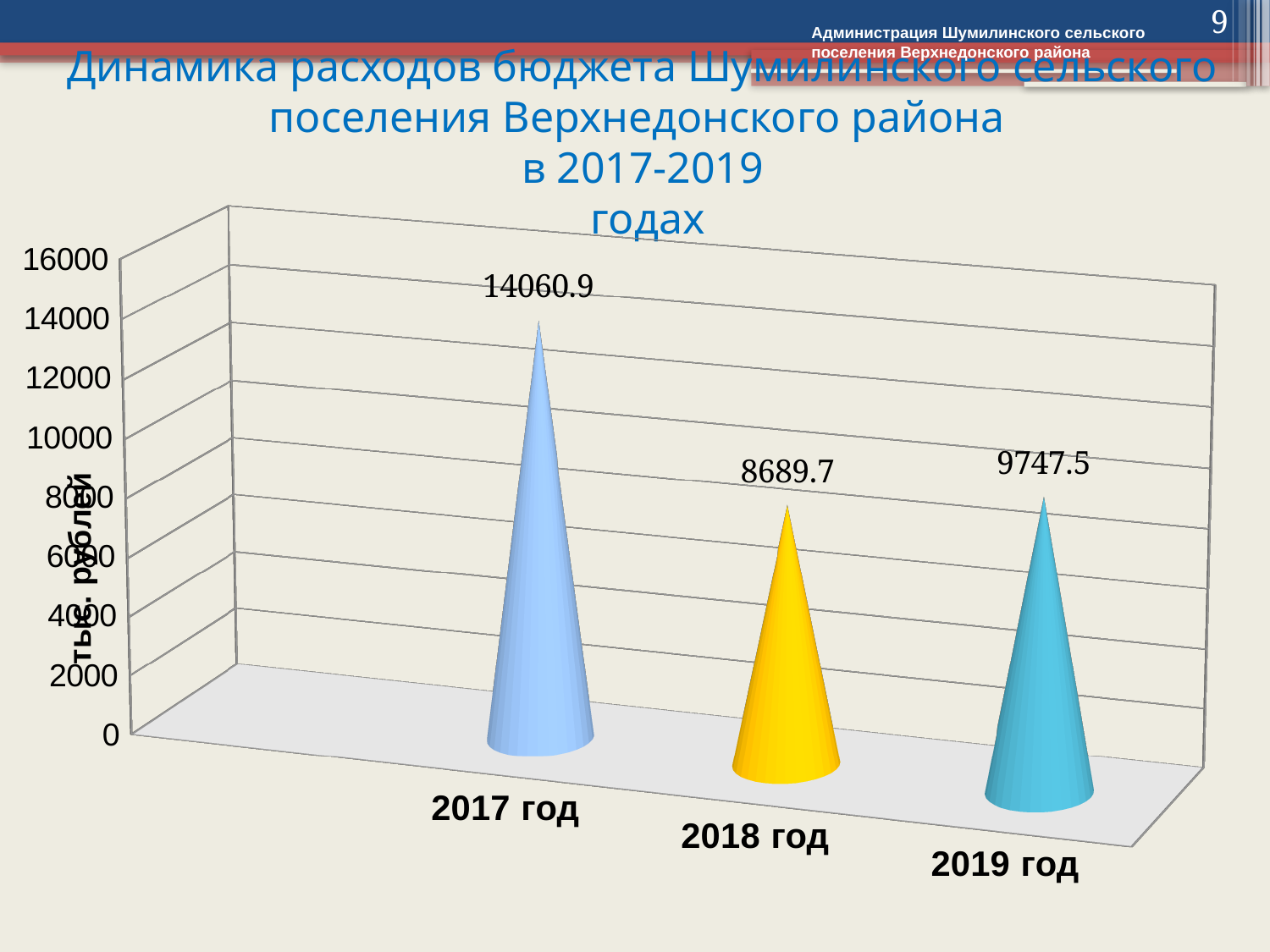
What is the difference between the values for 2017 год and 2018 год? 5371.2 Do the values rise or fall from 2017 год to 2018 год? fall What is the value shown for 2019 год? 9747.5 What is the difference between the values for 2019 год and 2018 год? 1057.8 Is the value for 2017 год greater or less than 12000? greater What unit is given on the vertical axis label of the chart? тыс. рублей What is the value shown for 2018 год? 8689.7 Which is larger, the value for 2018 год or the value for 2019 год? 2019 год Which year has the highest expenditure value? 2017 год How many years are plotted on the chart? 3 What is the budget expenditure value shown for 2017 год? 14060.9 Which year has the lowest expenditure value? 2018 год